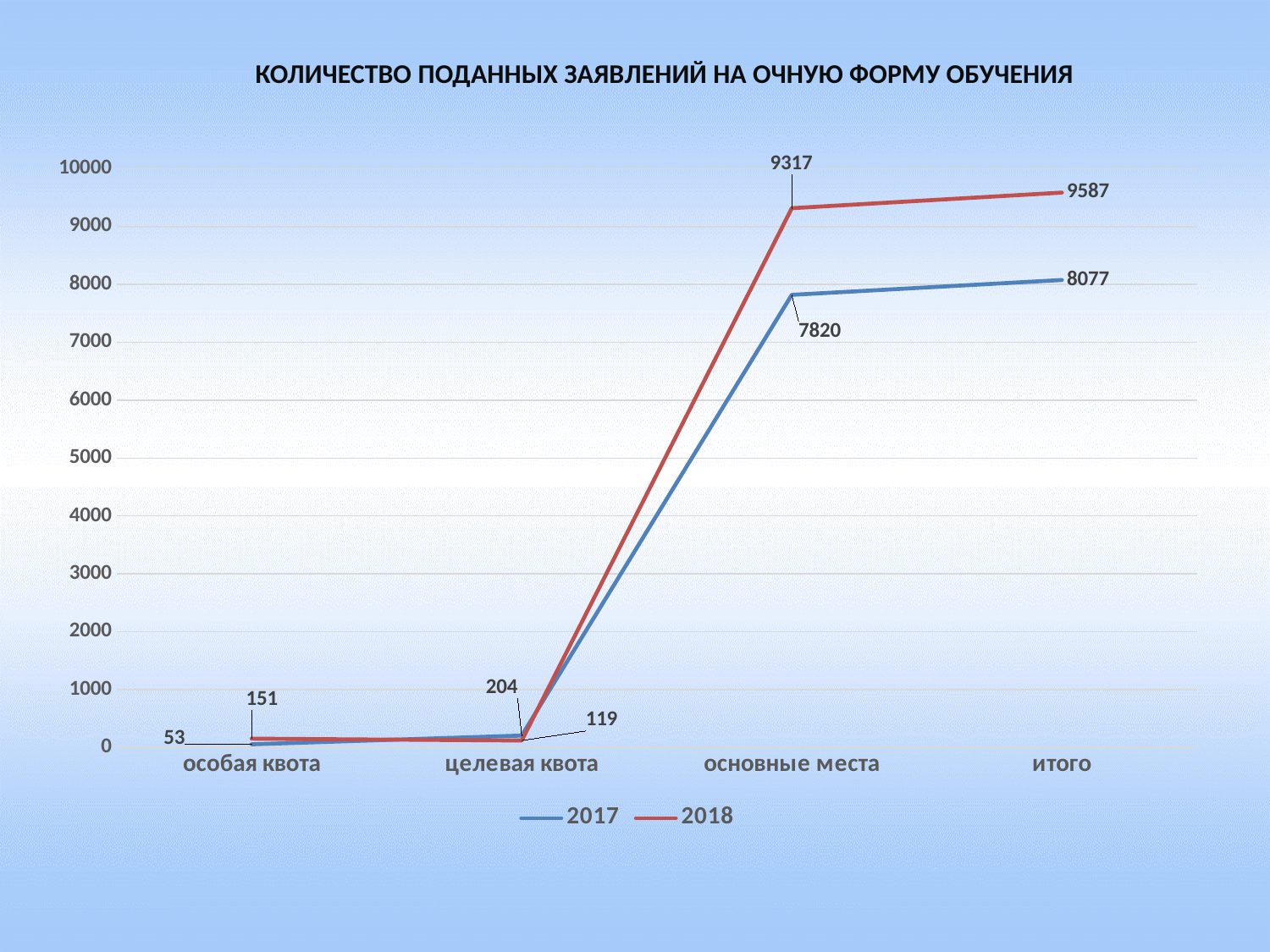
What is the value for 2018 in the category основные места? 9317 How many categories are shown on the x axis? 4 Which category has the highest value for the 2018 series? итого In the category целевая квота, which series has the larger value, 2017 or 2018? 2017 What is the title of the chart? КОЛИЧЕСТВО ПОДАННЫХ ЗАЯВЛЕНИЙ НА ОЧНУЮ ФОРМУ ОБУЧЕНИЯ What is the value for 2017 in the category итого? 8077 What type of chart is shown on the slide? line chart What is the value for 2017 in the category особая квота? 53 What is the difference between the 2018 and 2017 values in the category итого? 1510 How many series does the legend list? 2 What is the value for 2018 in the category целевая квота? 119 Which category has the lowest value for the 2017 series? особая квота